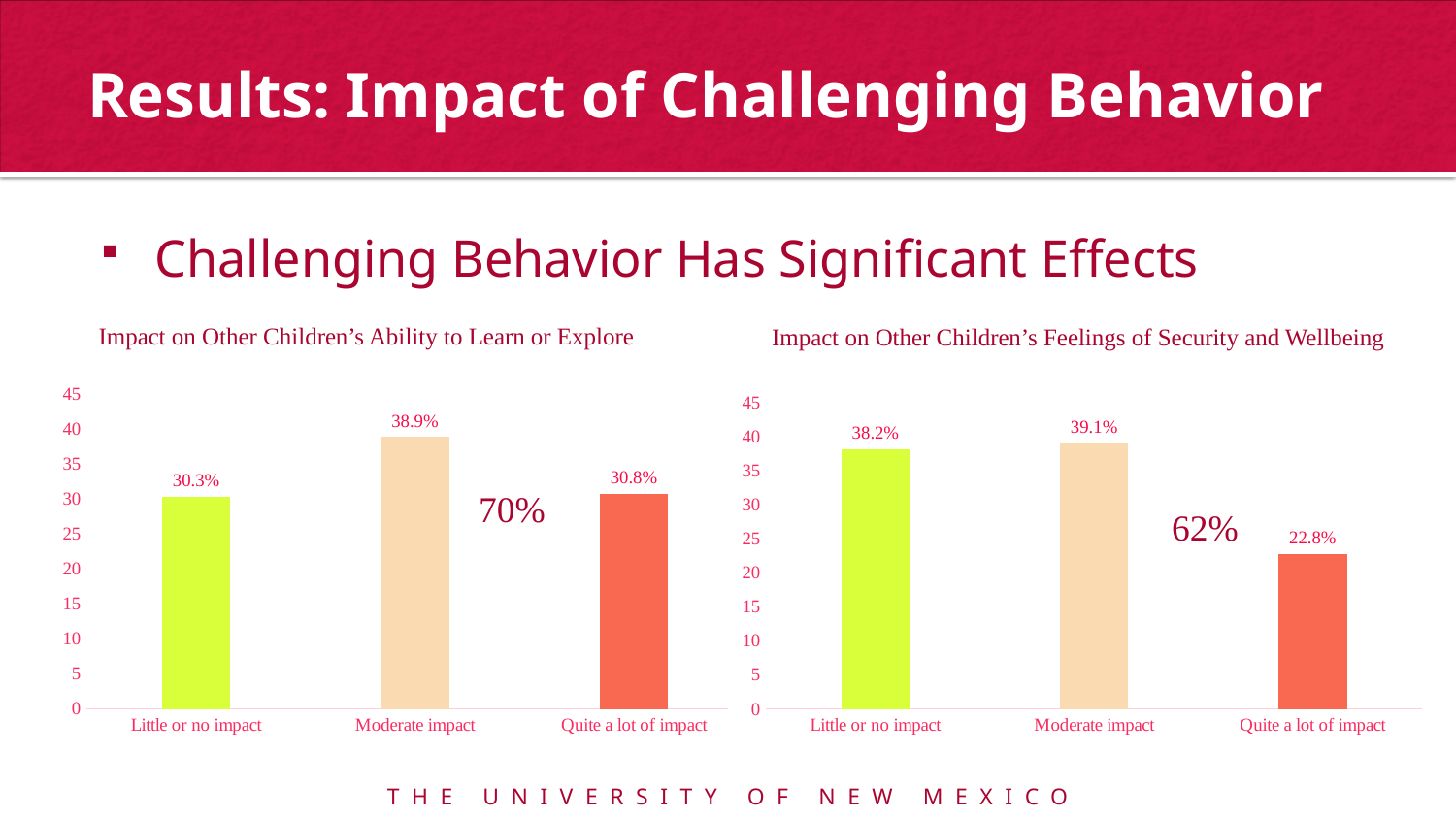
In the 'Impact on Other Children's Ability to Learn or Explore' chart, what is the difference between Moderate impact and Little or no impact? 8.6% In the 'Impact on Other Children's Feelings of Security and Wellbeing' chart, what is the difference between Moderate impact and Quite a lot of impact? 16.3% In the 'Impact on Other Children's Ability to Learn or Explore' chart, which category has the highest value? Moderate impact How many categories are shown in the 'Impact on Other Children's Ability to Learn or Explore' chart? 3 In the 'Impact on Other Children's Feelings of Security and Wellbeing' chart, what is the value for Quite a lot of impact? 22.8% In the 'Impact on Other Children's Feelings of Security and Wellbeing' chart, is the value for Little or no impact greater or less than 35? greater In the 'Impact on Other Children's Ability to Learn or Explore' chart, what is the value for Moderate impact? 38.9% In the 'Impact on Other Children's Ability to Learn or Explore' chart, which is larger: Little or no impact or Moderate impact? Moderate impact In the 'Impact on Other Children's Feelings of Security and Wellbeing' chart, which category has the lowest value? Quite a lot of impact In the 'Impact on Other Children's Ability to Learn or Explore' chart, what is the value for Little or no impact? 30.3% What percentage is printed in large text inside the 'Impact on Other Children's Feelings of Security and Wellbeing' chart? 62% What kind of chart is the 'Impact on Other Children's Feelings of Security and Wellbeing' chart? Bar chart